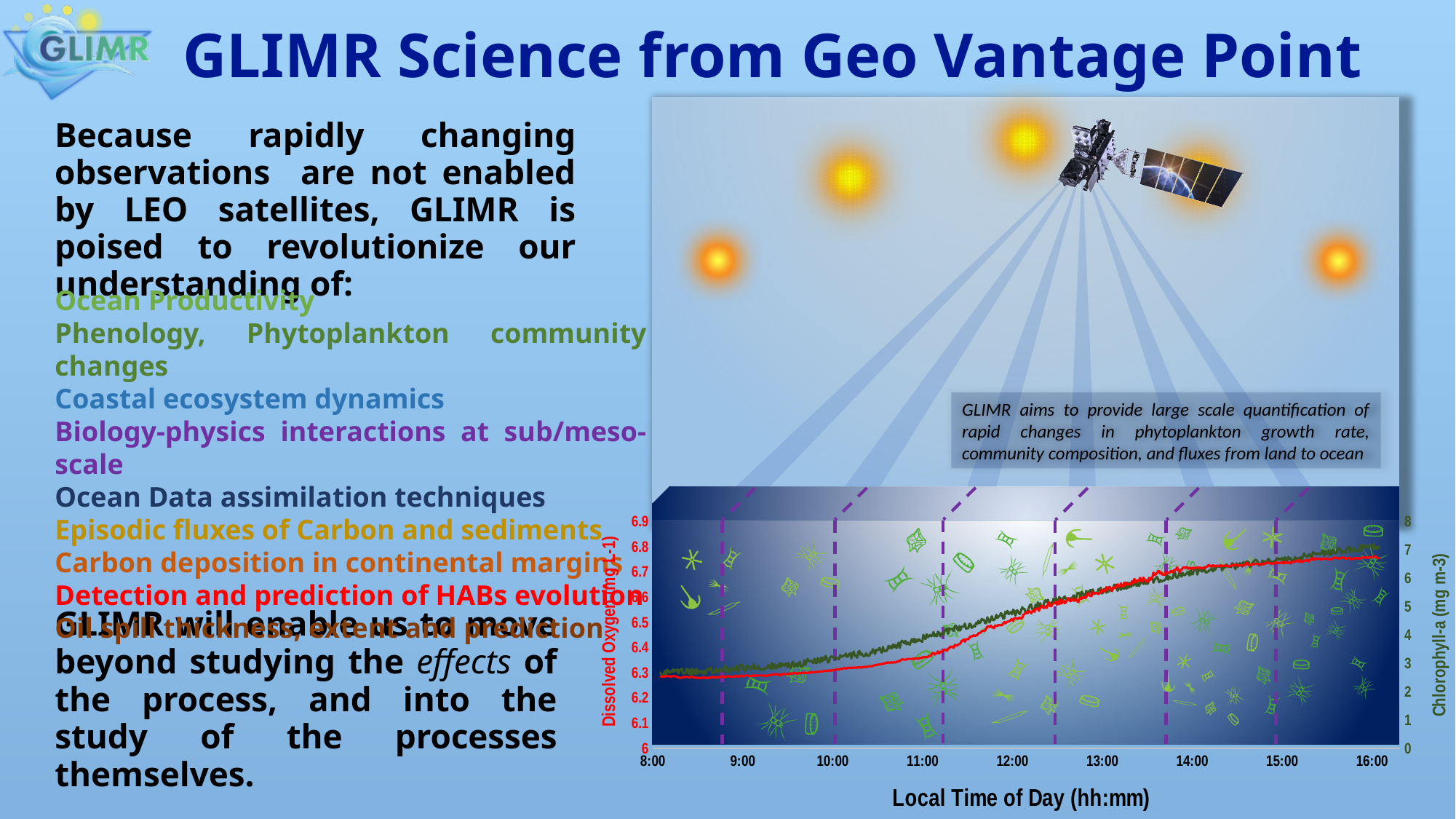
Does the red Dissolved Oxygen line rise or fall from 8:00 to 16:00? rise What is the highest value labelled on the left y axis of the chart? 6.9 What is the label of the x axis of the chart? Local Time of Day (hh:mm) Is the Dissolved Oxygen value at 10:00 greater or less than 6.5? less Is the Chlorophyll-a value at 16:00 greater or less than 6 on the right axis? greater Is the Chlorophyll-a value at 9:00 greater or less than 5 on the right axis? less What is the first time labelled on the x axis of the chart? 8:00 What is the label of the left y axis of the chart? Dissolved Oxygen (mg L-1) What kind of chart is shown at the bottom right of the slide? line chart How many time ticks are labelled on the x axis of the chart? 9 Does the green Chlorophyll-a line rise or fall across the day? rise